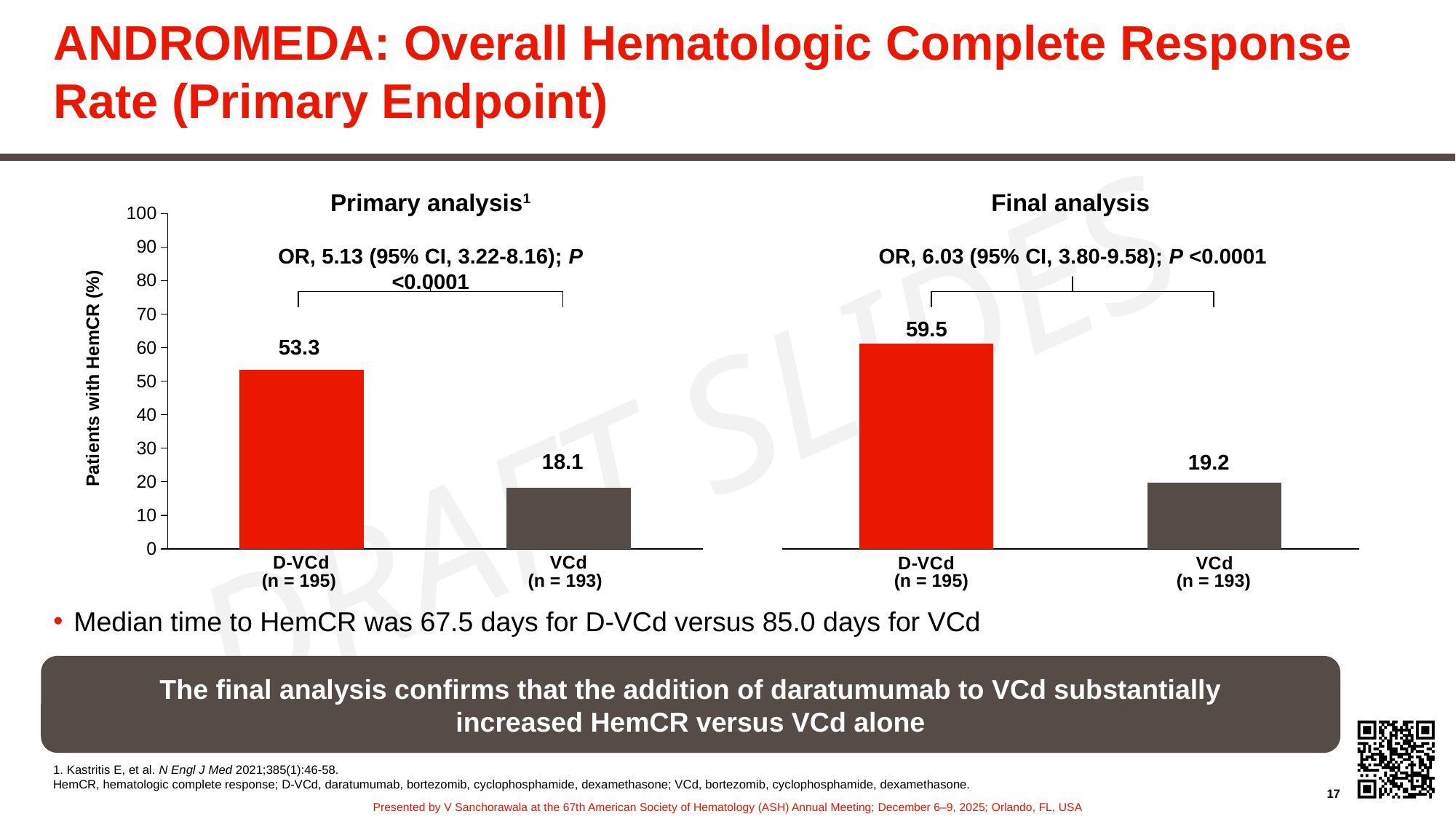
What is the y-axis label of the charts on the slide? Patients with HemCR (%) In the Primary analysis chart, what is the value for D-VCd? 53.3 In the Primary analysis chart, what is the difference between the D-VCd and VCd values? 35.2 How many bars are shown in the Primary analysis chart? 2 What type of chart is used to show the Final analysis results? bar chart In the Final analysis chart, what is the difference between the D-VCd and VCd values? 40.3 In the Final analysis chart, what is the value for VCd? 19.2 Is the D-VCd value in the Final analysis chart larger or smaller than the D-VCd value in the Primary analysis chart? larger In the Final analysis chart, what is the value for D-VCd? 59.5 In the Final analysis chart, which treatment arm has the higher HemCR rate? D-VCd In the Primary analysis chart, which treatment arm has the lower HemCR rate? VCd In the Primary analysis chart, what is the value for VCd? 18.1